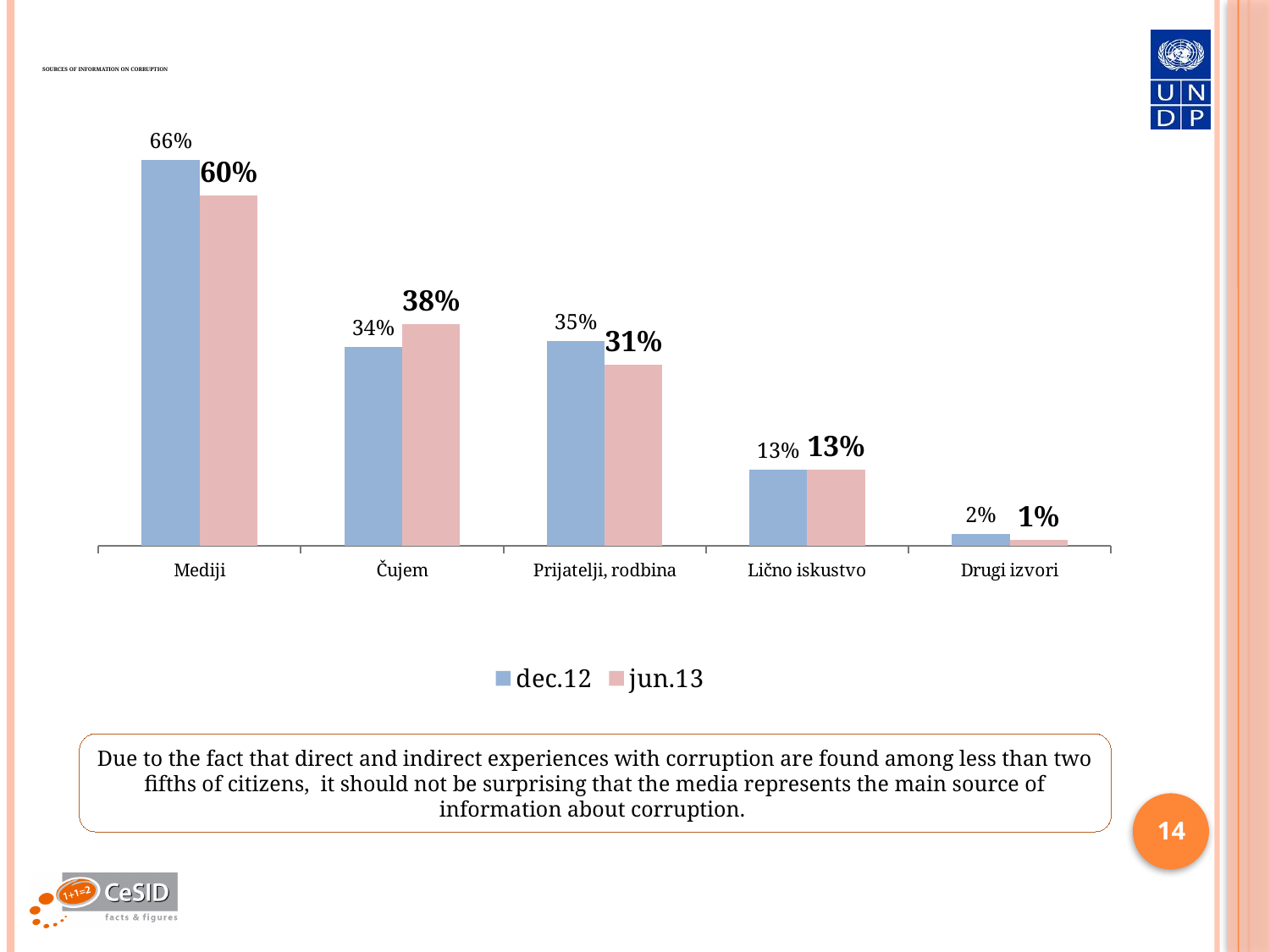
What kind of chart is shown on the slide? bar chart How many categories are shown on the x axis? 5 Which category has the highest jun.13 value? Mediji What is the difference between the dec.12 and jun.13 values for Mediji? 6% What is the dec.12 value for Drugi izvori? 2% What is the dec.12 value for Mediji? 66% Which category has the lowest dec.12 value? Drugi izvori Which series is shown in blue in the legend? dec.12 What is the jun.13 value for Prijatelji, rodbina? 31% Which is larger for Čujem, the dec.12 value or the jun.13 value? jun.13 What is the jun.13 value for Čujem? 38% How many series does the legend list? 2